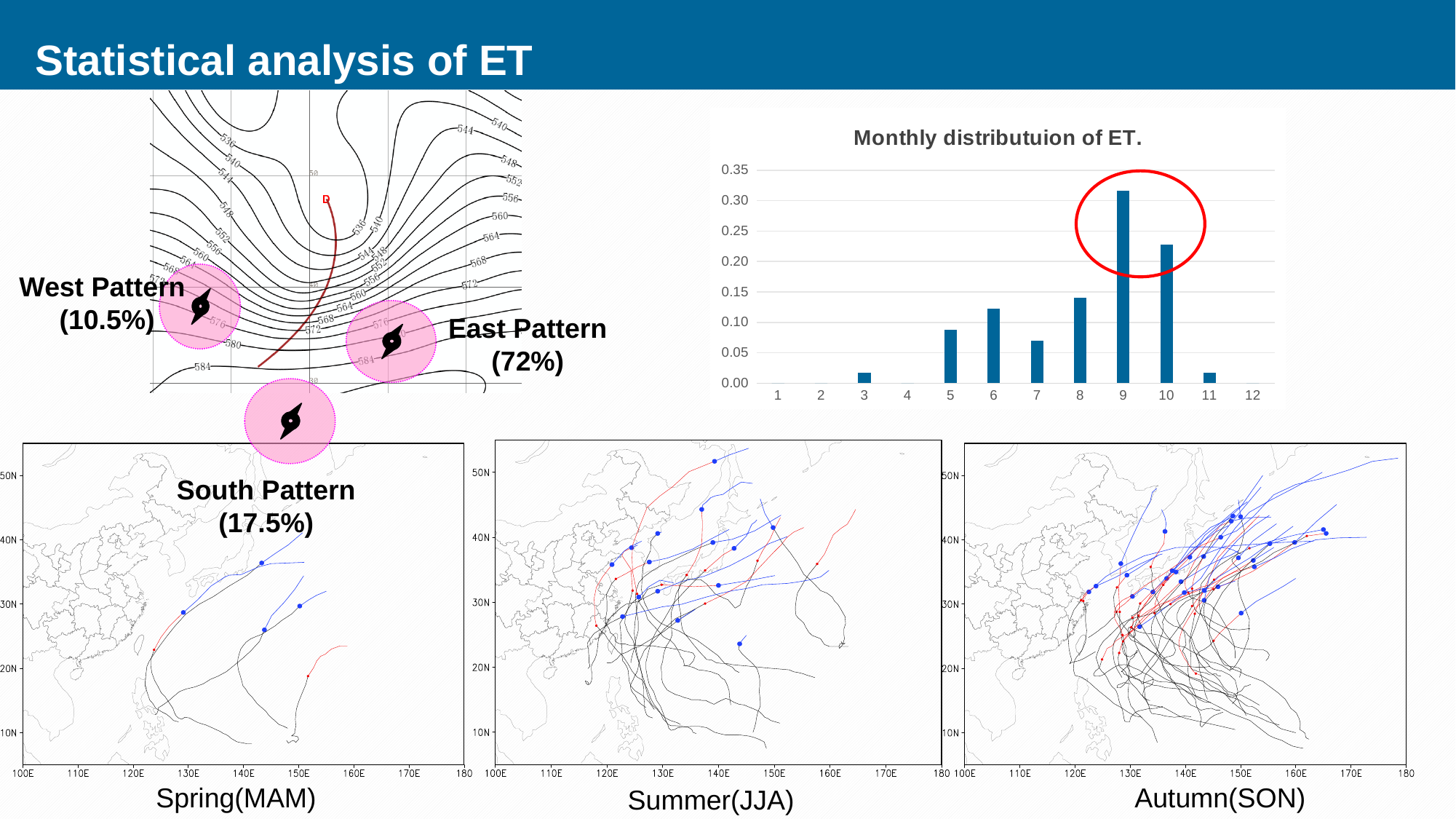
In the "Monthly distributuion of ET." chart, which is larger, the value for month 5 or month 8? month 8 In the "Monthly distributuion of ET." chart, is the value for month 7 greater or less than 0.10? less In the "Monthly distributuion of ET." chart, is the value for month 10 greater or less than 0.25? less Which two months are circled in red on the "Monthly distributuion of ET." chart? 9 and 10 In the "Monthly distributuion of ET." chart, is the value for month 9 greater or less than 0.30? greater What kind of chart is "Monthly distributuion of ET."? bar chart How many months are shown on the x axis of the "Monthly distributuion of ET." chart? 12 In the "Monthly distributuion of ET." chart, which month has the highest value? 9 In the "Monthly distributuion of ET." chart, do the values rise or fall from month 9 to month 12? fall In the "Monthly distributuion of ET." chart, which is larger, the value for month 9 or month 10? month 9